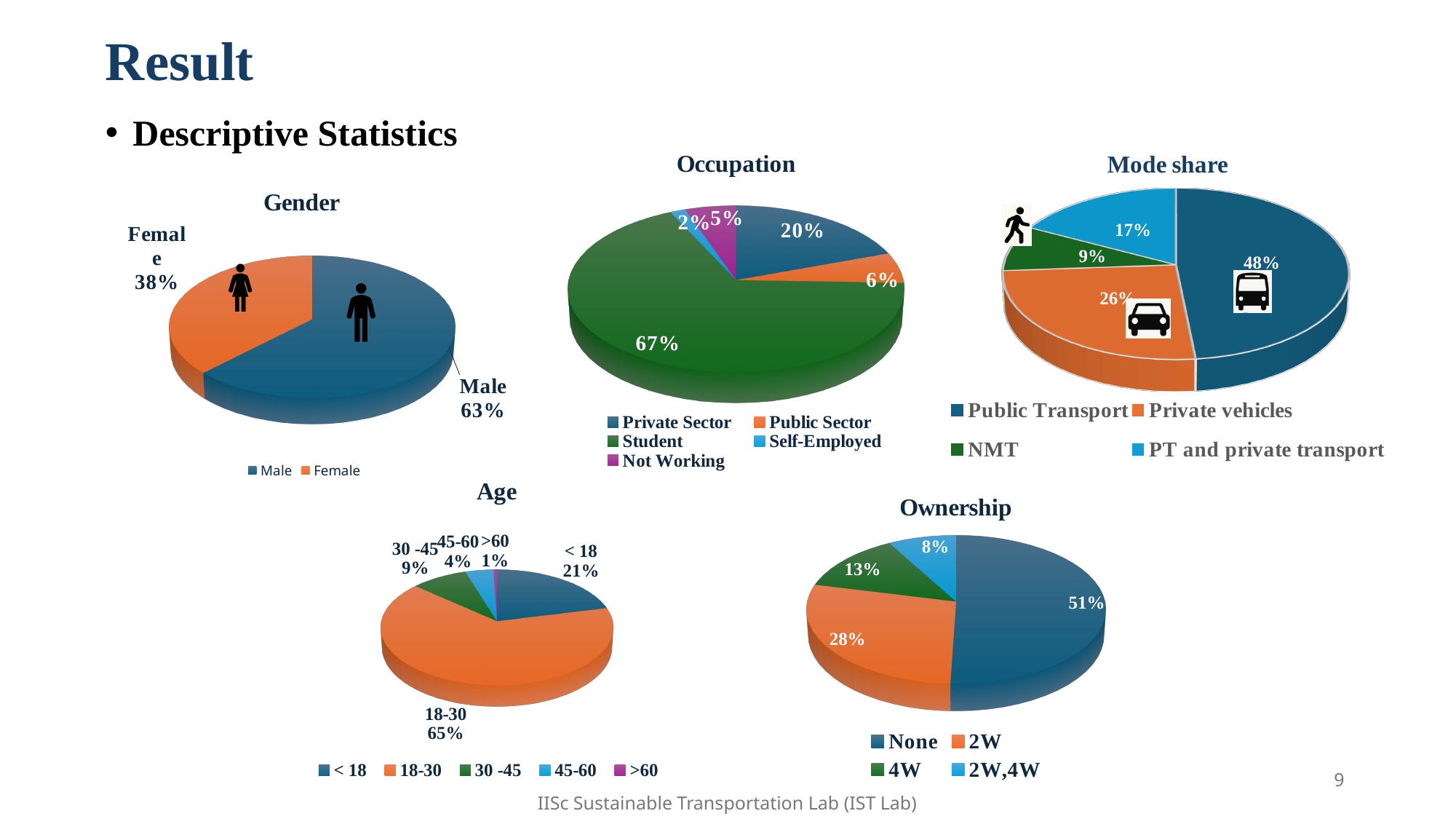
In the Ownership chart, which is larger, 4W or 2W,4W? 4W What kind of chart is the Ownership chart? Pie chart In the Mode share chart, what is the difference between Private vehicles and NMT? 17% In the Occupation chart, which category has the smallest share? Self-Employed In the Ownership chart, what share is 2W? 28% In the Mode share chart, how many categories does the legend list? 4 In the Mode share chart, what share is Public Transport? 48% In the Occupation chart, what share is Student? 67% In the Age chart, how many age groups are shown? 5 In the Age chart, which age group has the largest share? 18-30